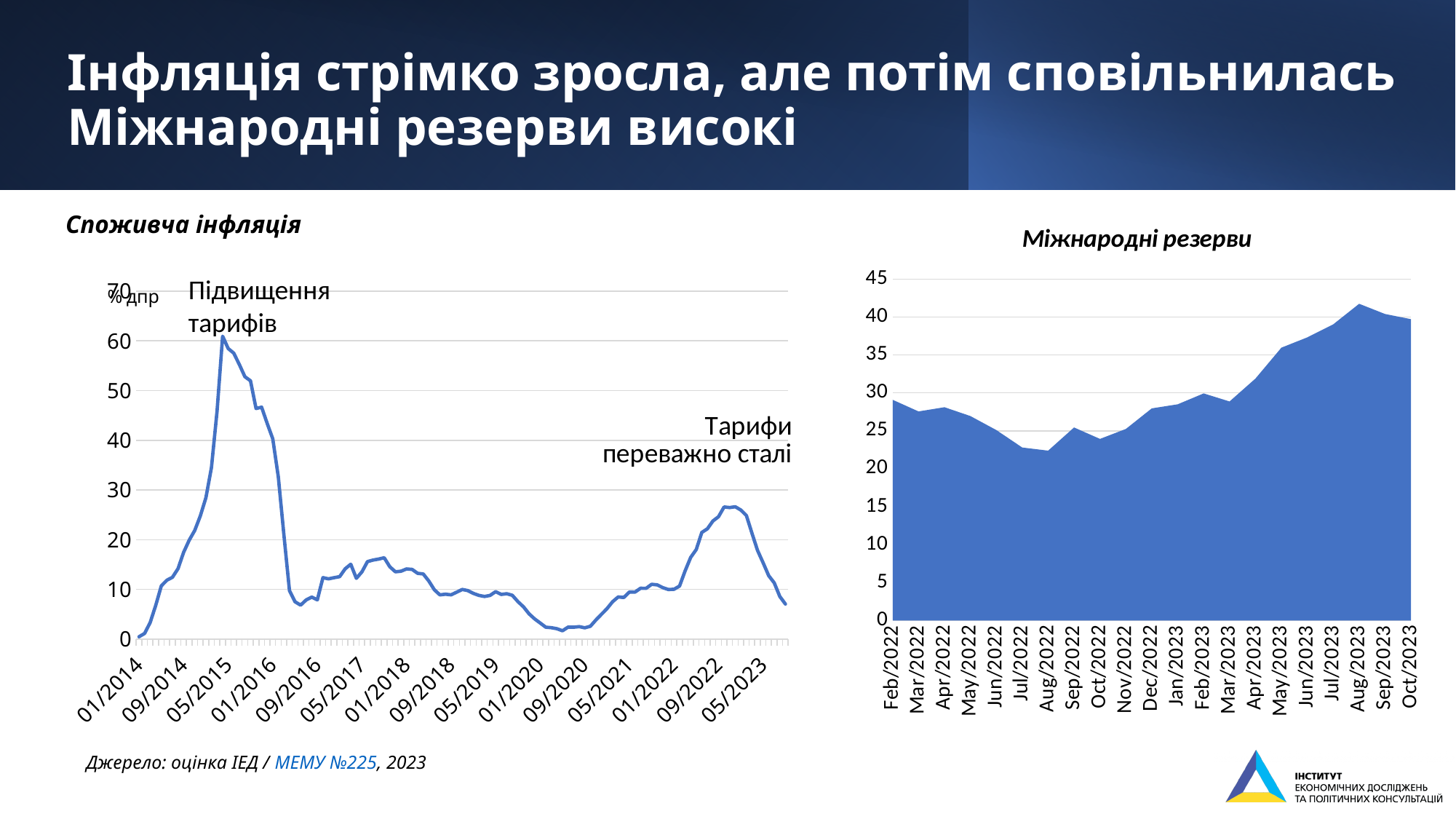
In the 'Споживча інфляція' chart, what is the highest value shown on the y axis? 70 In the 'Міжнародні резерви' chart, is the value for Aug/2023 greater or less than 40? greater What kind of chart is the 'Міжнародні резерви' chart on the right? area chart In the 'Міжнародні резерви' chart, how many months are shown on the x axis? 21 In the 'Міжнародні резерви' chart, do the values rise or fall from Mar/2023 to Aug/2023? rise In the 'Міжнародні резерви' chart, is the value for Jul/2022 greater or less than 25? less In the 'Міжнародні резерви' chart, is the value for Jun/2023 greater or less than 35? greater In the 'Міжнародні резерви' chart, which is larger, the value for Feb/2022 or the value for Aug/2023? Aug/2023 In the 'Міжнародні резерви' chart, which month has the highest value? Aug/2023 In the 'Споживча інфляція' chart, which is larger, the peak in 2015 or the peak in 2022? the peak in 2015 What kind of chart is the 'Споживча інфляція' chart on the left? line chart